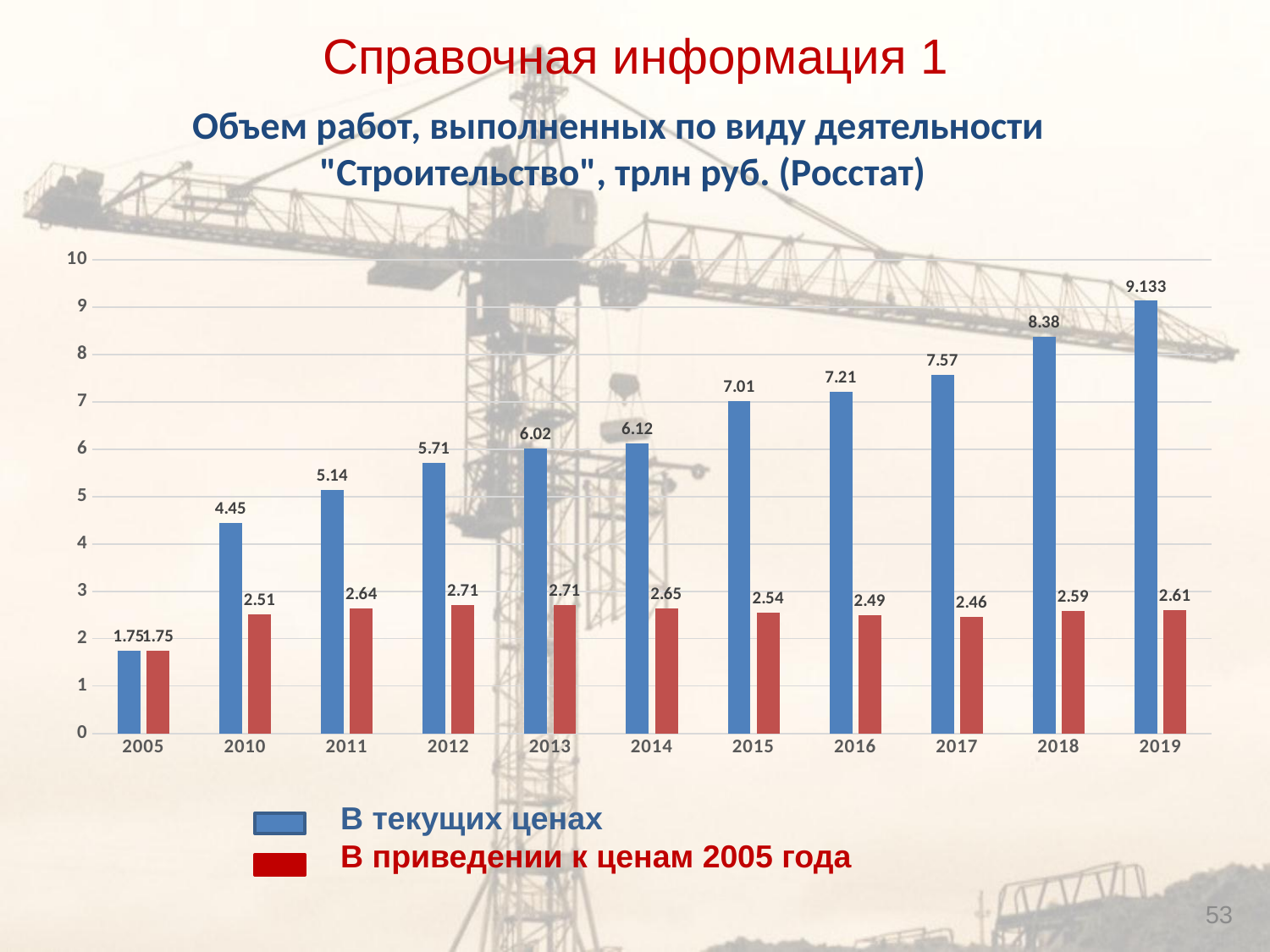
How many years are shown on the x axis? 11 Which colour represents the "В приведении к ценам 2005 года" series? red Does the "В текущих ценах" series rise or fall from 2005 to 2019? rise What is the value for 2015 in the "В текущих ценах" series? 7.01 How many series does the legend list? 2 What is the difference between the "В текущих ценах" value and the "В приведении к ценам 2005 года" value for 2018? 5.79 Which year has the highest value in the "В текущих ценах" series? 2019 What is the value for 2019 in the "В текущих ценах" series? 9.133 What kind of chart is shown on the slide? bar chart Which year has the lowest value in the "В приведении к ценам 2005 года" series? 2005 What is the value for 2012 in the "В приведении к ценам 2005 года" series? 2.71 Which is larger: the "В приведении к ценам 2005 года" value for 2011 or for 2017? 2011